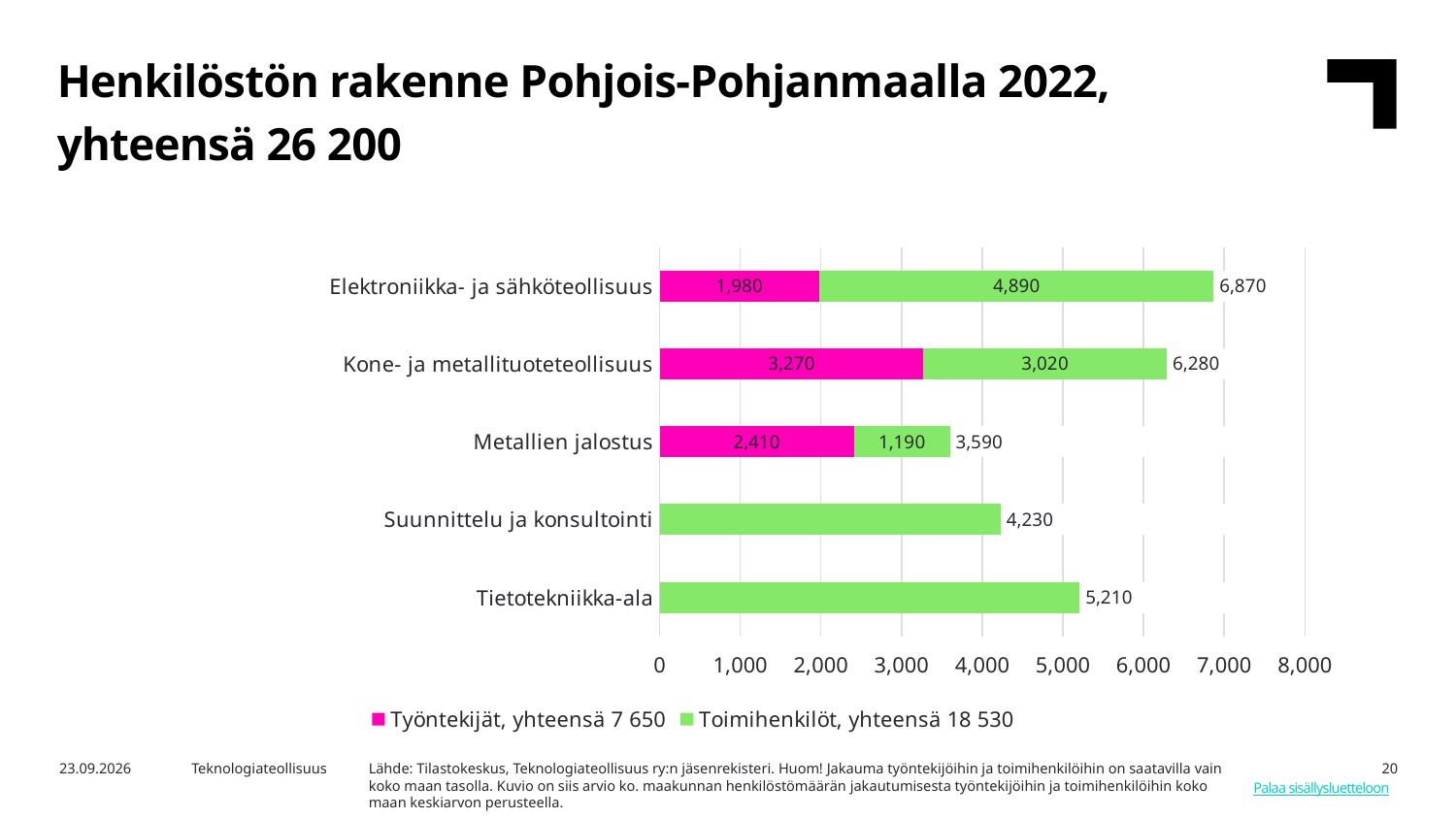
What is the difference between the total for Tietotekniikka-ala and the total for Suunnittelu ja konsultointi? 980 What is the Toimihenkilöt value for Elektroniikka- ja sähköteollisuus? 4,890 What is the total value of the bar for Metallien jalostus? 3,590 What is the Työntekijät value for Kone- ja metallituoteteollisuus? 3,270 Which category has the lowest total value? Metallien jalostus What type of chart is shown on the slide? Stacked bar chart Is the total value for Tietotekniikka-ala greater or less than 5,000? greater How many categories are shown on the chart? 5 What total is given for Toimihenkilöt in the legend? 18 530 How many series does the legend list? 2 Which is larger: the Työntekijät value for Metallien jalostus or the Työntekijät value for Elektroniikka- ja sähköteollisuus? Metallien jalostus Which category has the highest total value? Elektroniikka- ja sähköteollisuus